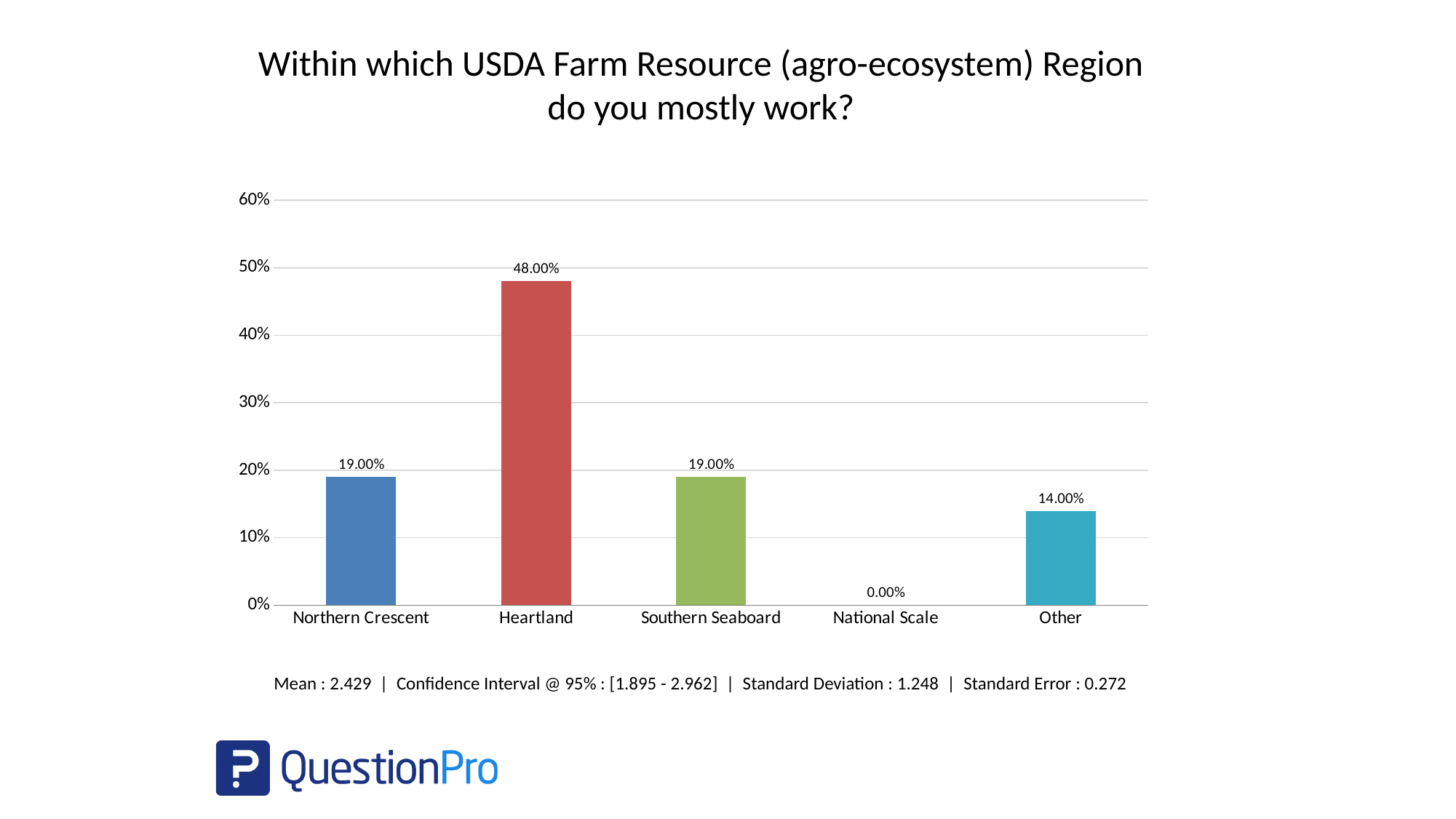
Which category has the highest value? Heartland What is the value for Northern Crescent? 19.00% Which category has the lowest value? National Scale Is the value for Heartland greater or less than 40%? greater Which is larger, the value for Northern Crescent or the value for Other? Northern Crescent What is the difference between the values for Heartland and Southern Seaboard? 29.00% What is the title of the chart? Within which USDA Farm Resource (agro-ecosystem) Region do you mostly work? What kind of chart is shown on the slide? bar chart What is the value for Heartland? 48.00% What is the value for National Scale? 0.00% How many categories are shown on the x axis? 5 What is the value for Other? 14.00%